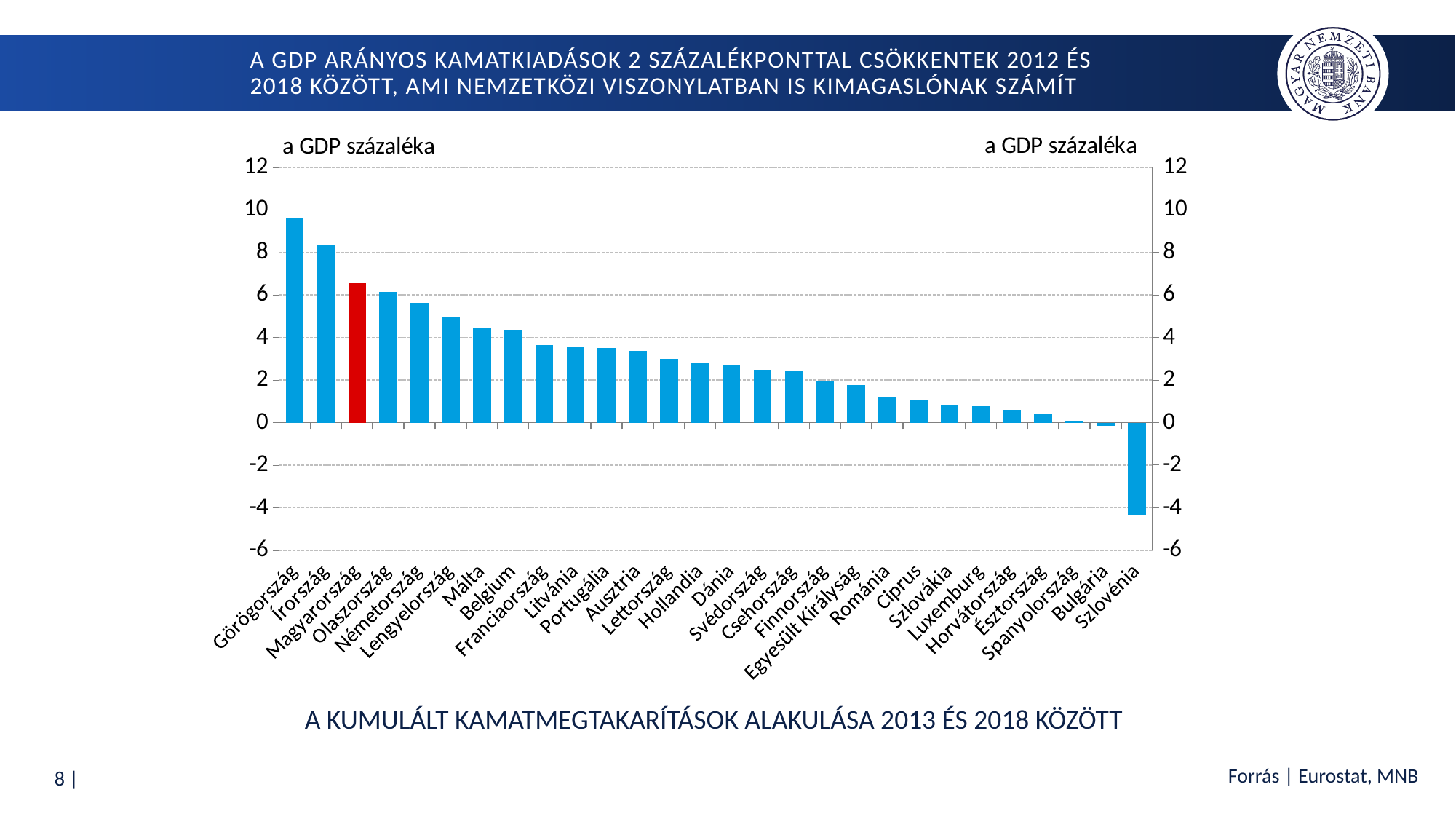
What kind of chart is shown on the slide? bar chart Which country's bar is highlighted in red? Magyarország Which country has the lowest value in the chart? Szlovénia How many countries are shown on the x axis of the chart? 28 Is the value for Szlovénia greater or less than -4? less Which country has the highest value in the chart? Görögország Is the value for Görögország greater or less than 8? greater Is the value for Németország greater or less than 6? less Do the values generally rise or fall moving from left to right along the x axis? fall Which has the larger value, Írország or Magyarország? Írország What is the title shown below the chart? A KUMULÁLT KAMATMEGTAKARÍTÁSOK ALAKULÁSA 2013 ÉS 2018 KÖZÖTT